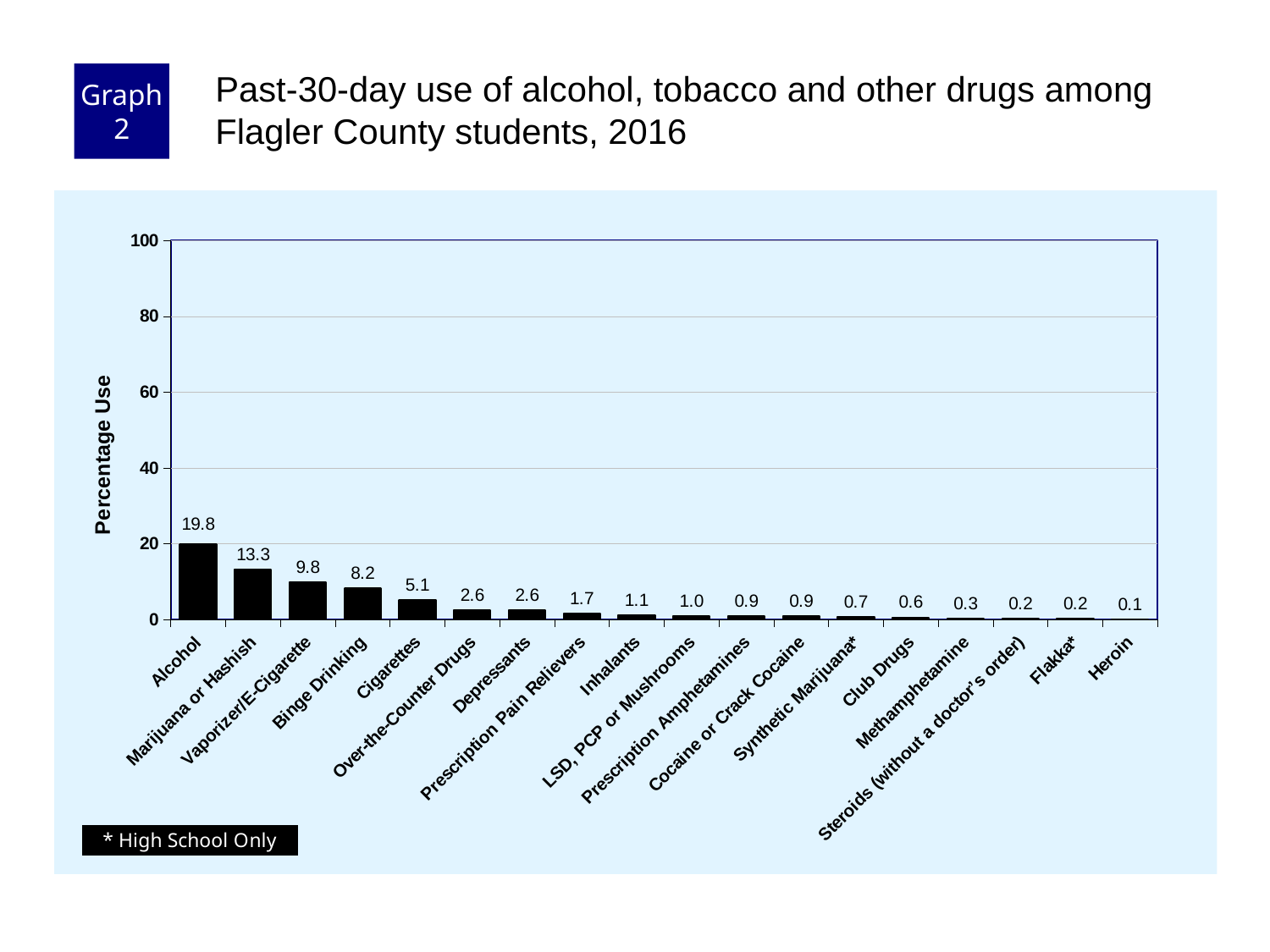
What kind of chart is shown on the slide? bar chart Which category has the lowest percentage use? Heroin Which category has the highest percentage use? Alcohol Is the value for Alcohol greater or less than 20? less What is the percentage use for Alcohol? 19.8 What is the percentage use for Methamphetamine? 0.3 What is the difference in percentage use between Alcohol and Marijuana or Hashish? 6.5 Which has a higher percentage use, Binge Drinking or Cigarettes? Binge Drinking How many categories are shown on the x axis? 18 What is the percentage use for Cigarettes? 5.1 What is the percentage use for Vaporizer/E-Cigarette? 9.8 What is the label of the y axis? Percentage Use